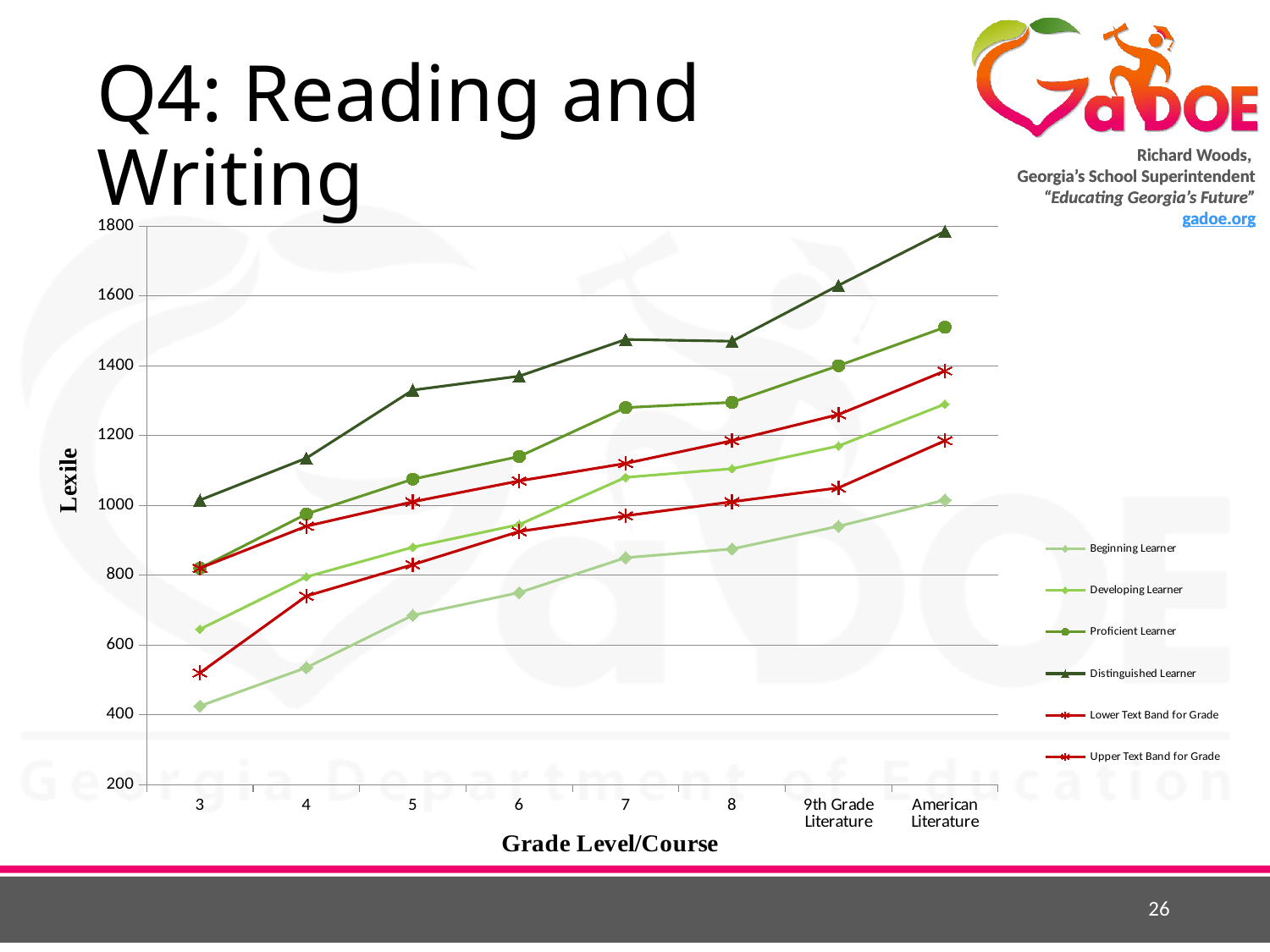
At grade 8, which is larger: Proficient Learner or Upper Text Band for Grade? Proficient Learner How many series does the legend list? 6 What is the title of the vertical axis? Lexile Which series has the lowest value at grade 3? Beginning Learner Is the value for Proficient Learner at grade 7 greater or less than 1200? greater How many grade levels/courses are plotted along the x axis? 8 Do the Distinguished Learner values rise or fall from grade 3 to American Literature? rise Which series has the highest value at American Literature? Distinguished Learner Is the value for Developing Learner at grade 6 greater or less than 1000? less What kind of chart is shown on the slide? line chart Is the value for Distinguished Learner at American Literature greater or less than 1600? greater